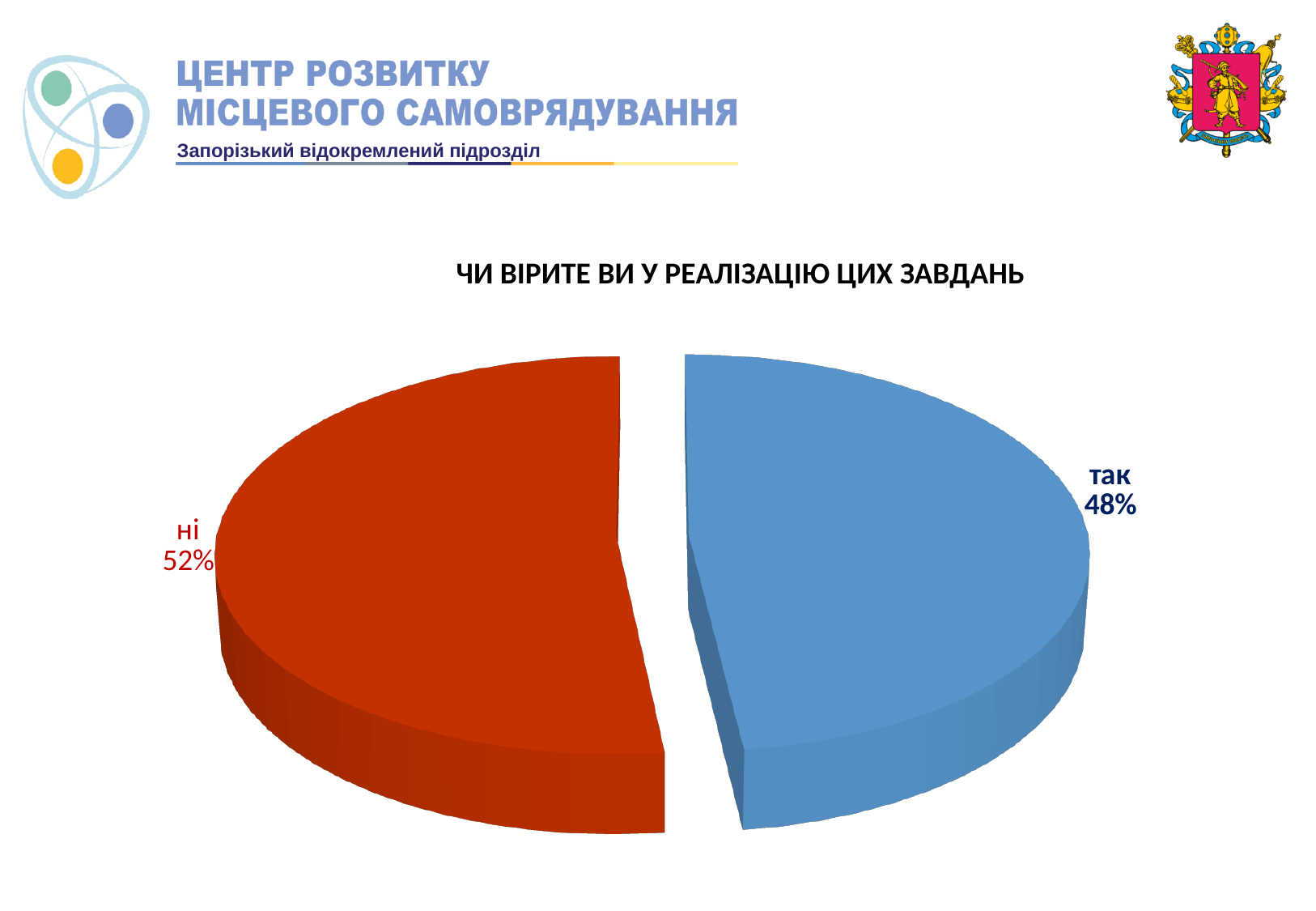
Which is larger, the "так" slice or the "ні" slice? ні Is the share for "так" greater or less than 50%? less Which slice is the largest in the pie chart? ні What share of the pie does the "так" slice represent? 48% What kind of chart is shown on the slide? pie chart What share of the pie does the "ні" slice represent? 52% Which slice is the smallest in the pie chart? так How many slices does the pie chart have? 2 What colour is the "ні" slice? red What is the difference in percentage points between the "ні" and "так" slices? 4 What is the title of the chart? ЧИ ВІРИТЕ ВИ У РЕАЛІЗАЦІЮ ЦИХ ЗАВДАНЬ